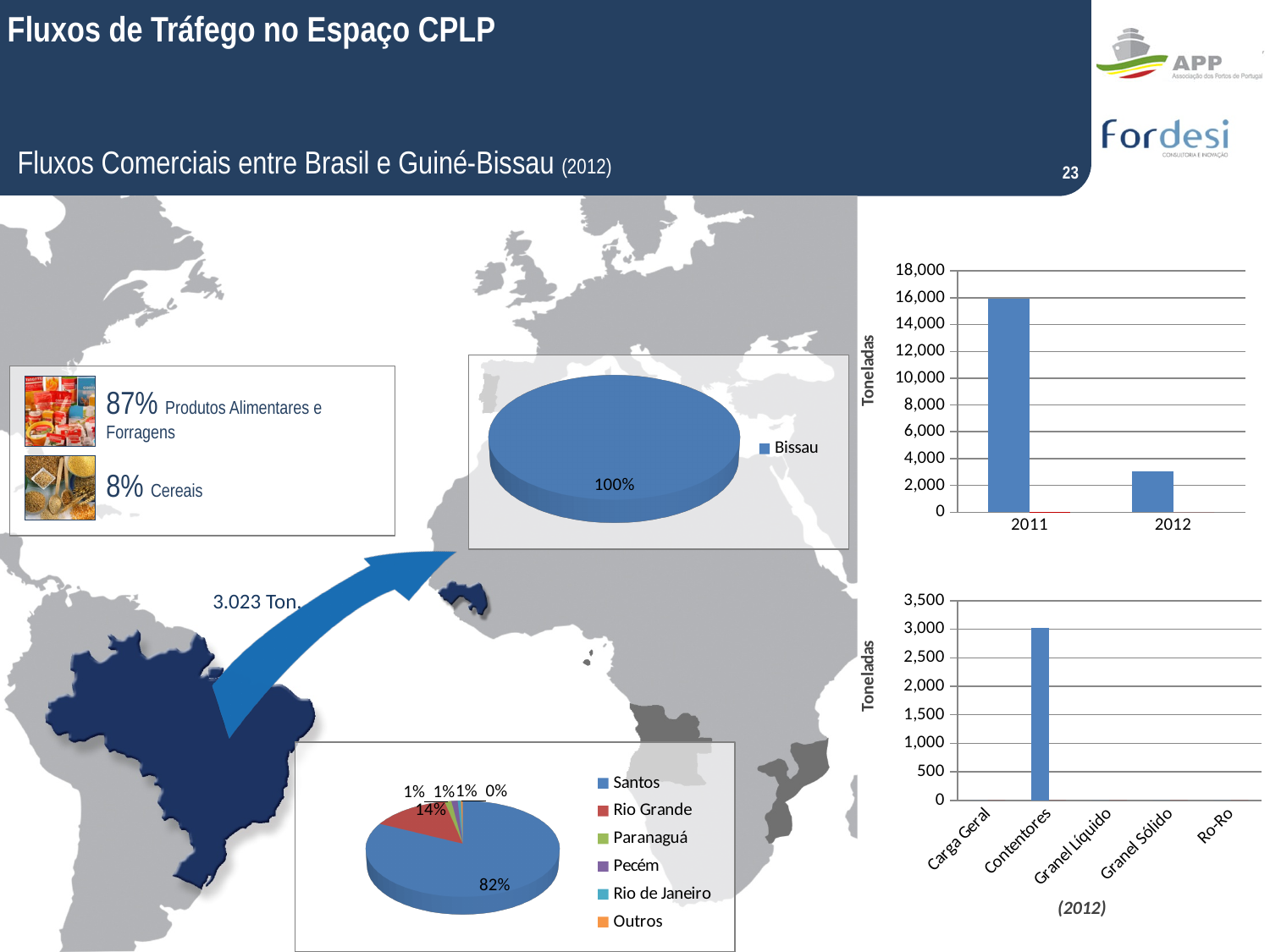
In the pie chart at the bottom of the slide, what is the difference in percentage points between the Santos share and the Rio Grande share? 68 percentage points In the bottom-right bar chart of cargo types (2012), how many categories are shown on the x axis? 5 In the bottom-right bar chart of cargo types (2012), which category has the highest value? Contentores In the pie chart at the bottom of the slide, what share does Rio Grande have? 14% In the pie chart at the bottom of the slide, which port has the largest share? Santos In the top-right bar chart with years on the x axis, is the value for 2011 greater or less than 14,000? greater In the pie chart at the bottom of the slide, how many entries does the legend list? 6 In the top-right bar chart with years on the x axis, is the value for 2012 greater or less than 4,000? less In the top-right bar chart with years on the x axis, which year has the higher value? 2011 In the pie chart in the centre of the map, what share is shown for Bissau? 100% What kind of chart is the chart in the centre of the map showing Bissau? Pie chart In the pie chart at the bottom of the slide, what share does Santos have? 82%